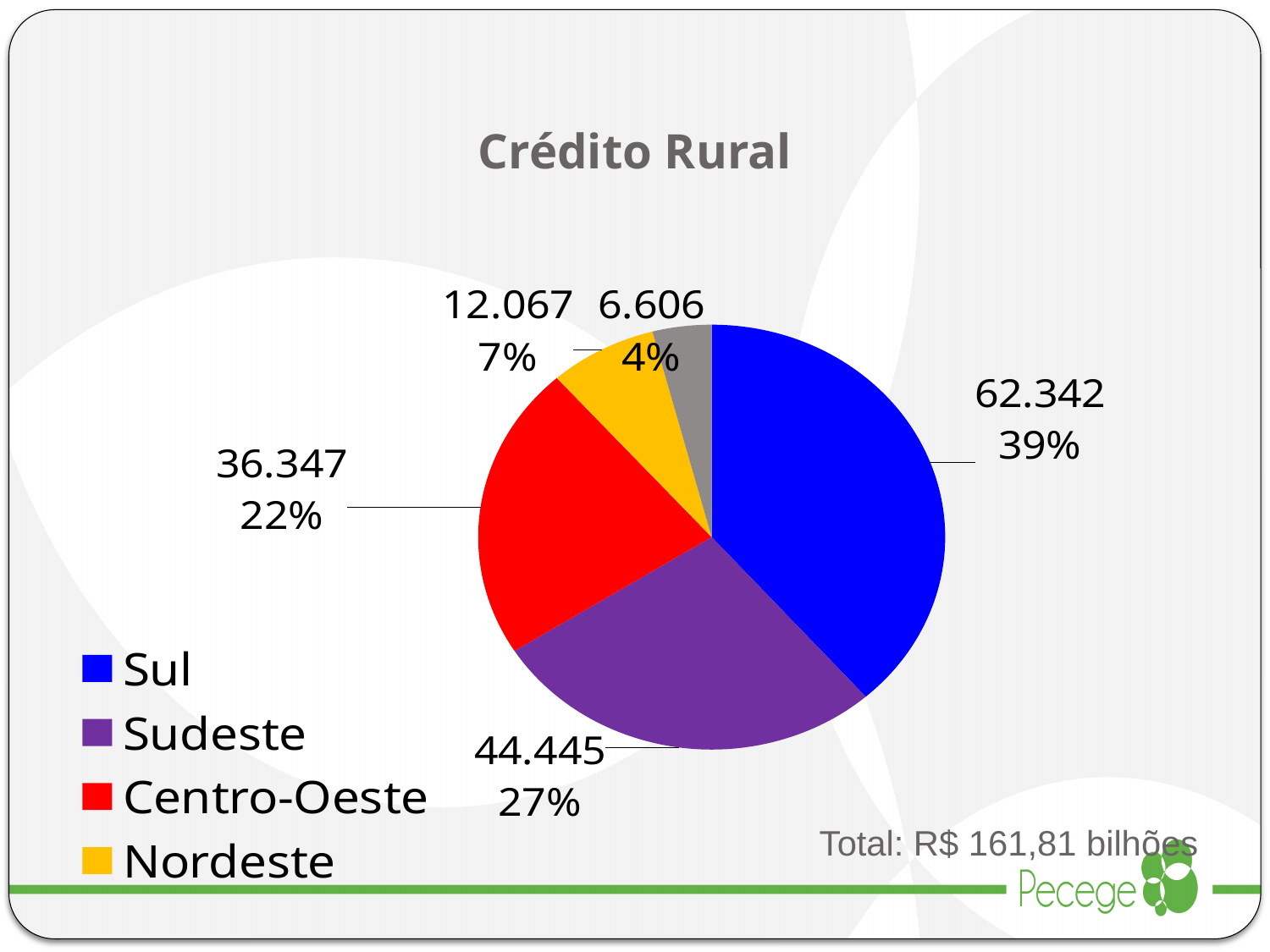
What is the difference between the values for Sul and Sudeste? 17.897 What is the title of the chart? Crédito Rural What percentage share does Nordeste have? 7% What value is shown for the Sul slice? 62.342 How many slices does the pie chart have? 5 What percentage share does the Sudeste slice have? 27% What total is stated on the slide for the chart? R$ 161,81 bilhões What value is shown for Centro-Oeste? 36.347 Which is larger, the Centro-Oeste slice or the Nordeste slice? Centro-Oeste What type of chart is shown on the slide? pie chart Which region has the largest slice of the pie? Sul Which of the labelled regions in the legend has the smallest slice? Nordeste